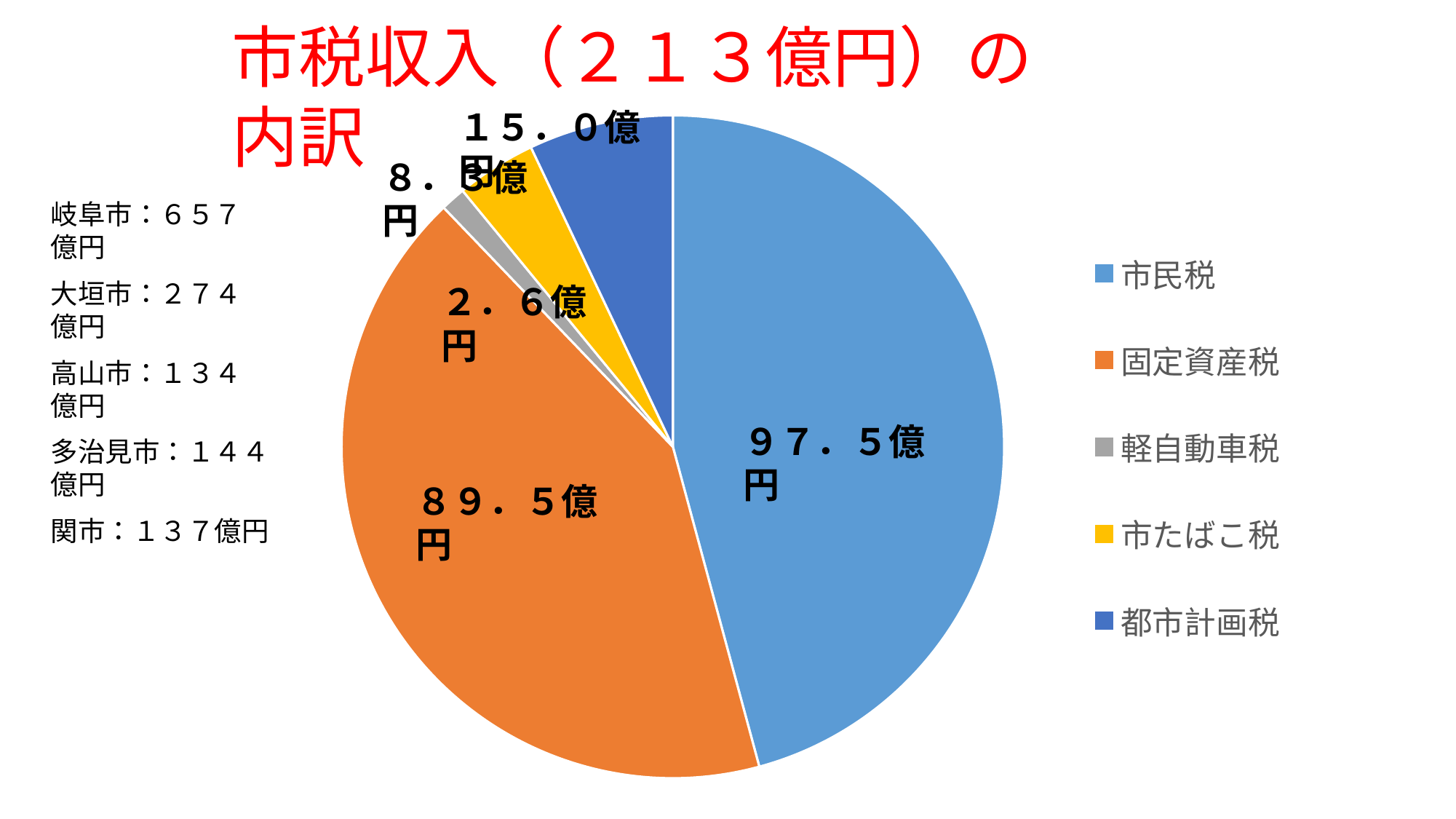
What kind of chart is shown on the slide? pie chart What is the value for 軽自動車税? ２．６億円 Which is larger, 市民税 or 固定資産税? 市民税 What is the value for 市民税? ９７．５億円 What is the difference between the values for 市民税 and 固定資産税? ８．０億円 What is the value for 固定資産税? ８９．５億円 What is the title of the chart? 市税収入（２１３億円）の内訳 What is the value for 都市計画税? １５．０億円 Which category has the largest slice of the pie? 市民税 How many slices does the pie chart have? 5 Which category has the smallest slice of the pie? 軽自動車税 How many entries does the legend list? 5